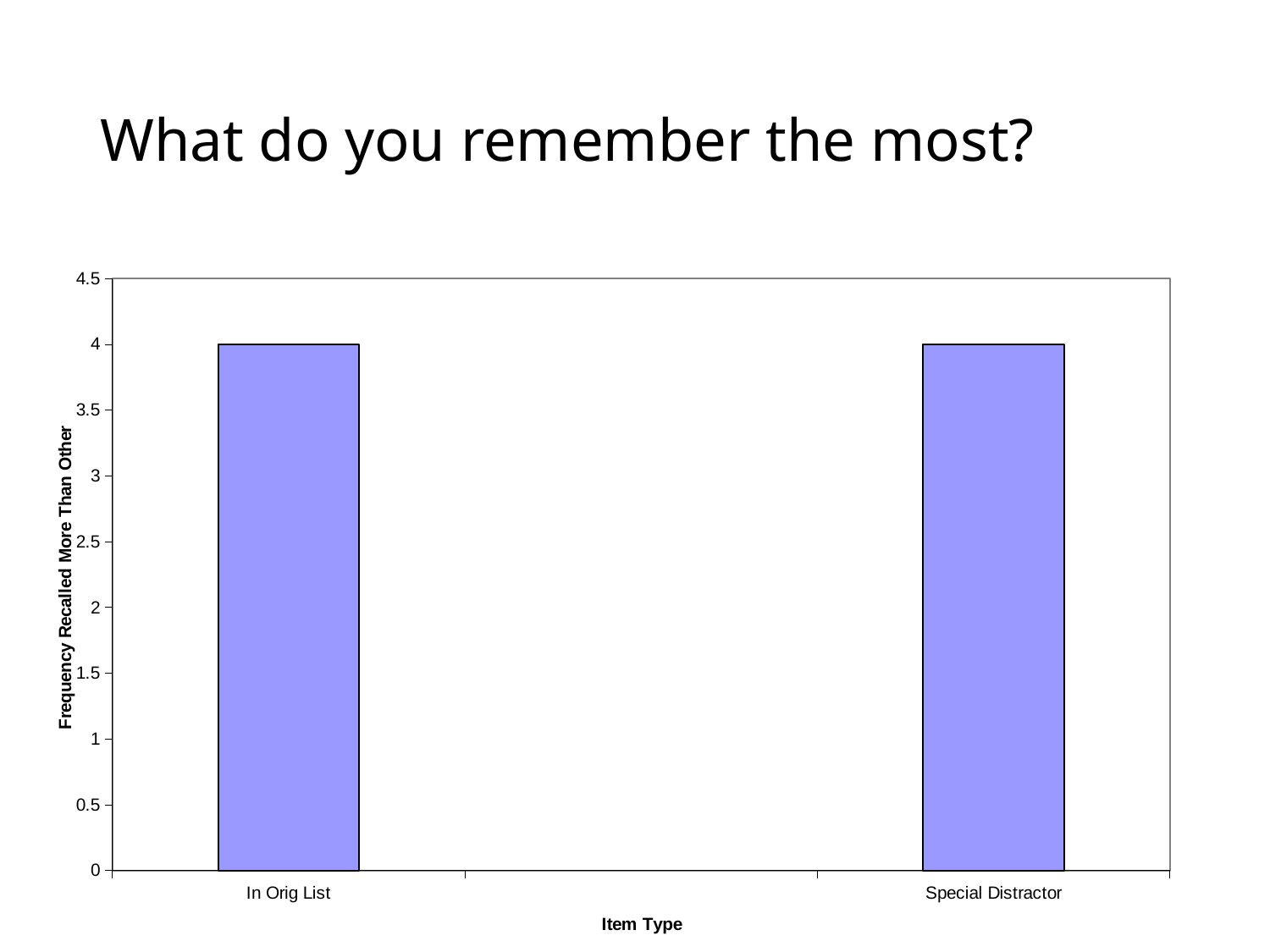
What type of chart is shown on the slide? bar chart Is the value for In Orig List greater or less than 3? greater What is the value for Special Distractor? 4 What is the title of the y axis? Frequency Recalled More Than Other What is the difference between the values for In Orig List and Special Distractor? 0 What is the title of the x axis? Item Type How many bars are plotted in the chart? 2 What is the highest value shown on the y axis? 4.5 Is the value for Special Distractor greater or less than 4.5? less Is the value for Special Distractor greater or less than 2? greater What is the value for In Orig List? 4